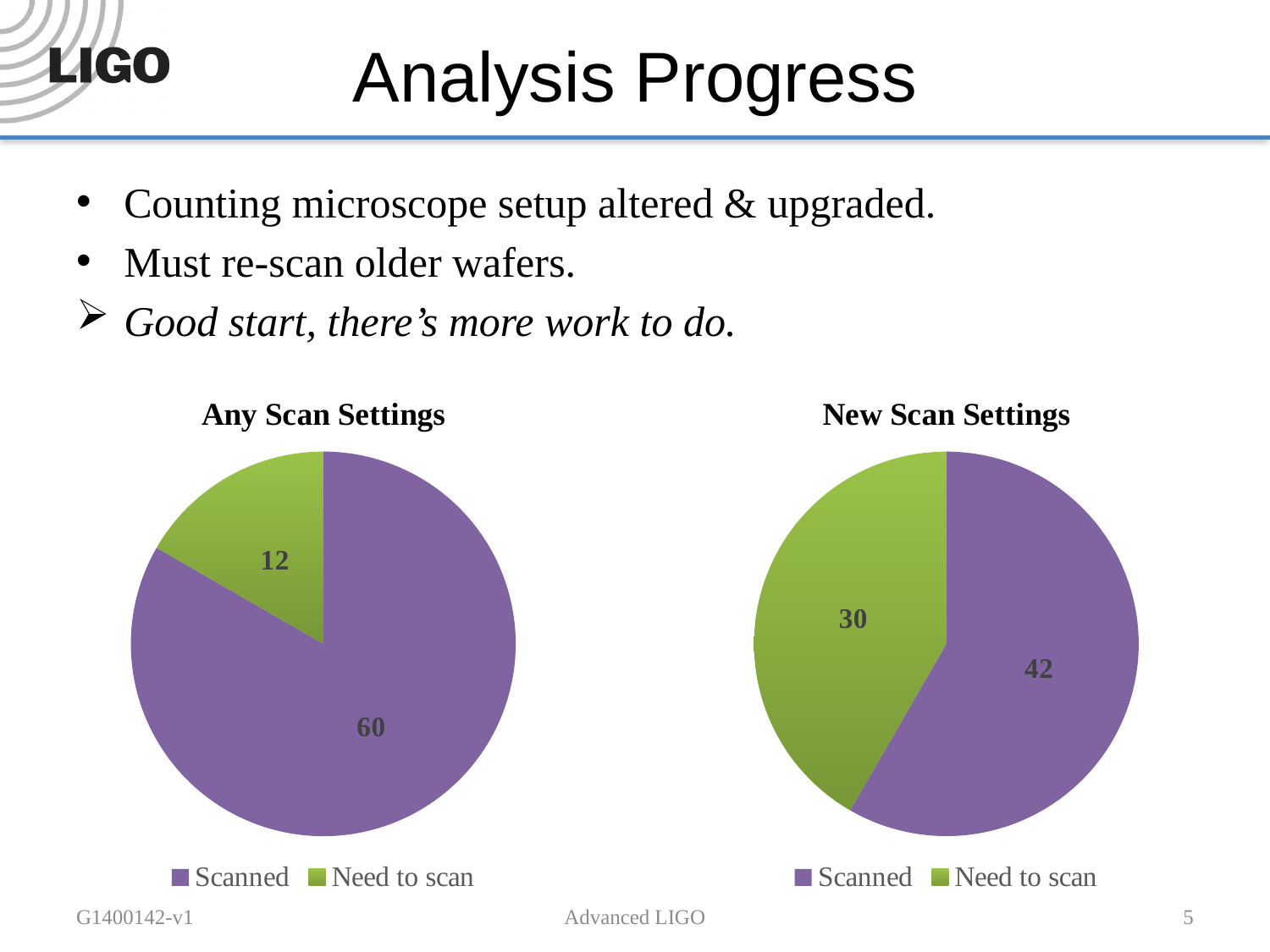
In the 'Any Scan Settings' chart, which category has the largest slice? Scanned In the 'New Scan Settings' chart, what is the difference between Scanned and Need to scan? 12 In the 'New Scan Settings' chart, which category has the smallest slice? Need to scan In the 'Any Scan Settings' chart, what is the value for Scanned? 60 In the 'Any Scan Settings' chart, what is the value for Need to scan? 12 In the 'New Scan Settings' chart, which is larger, Scanned or Need to scan? Scanned What type of chart is the 'Any Scan Settings' chart? Pie chart How many categories does the legend of the 'New Scan Settings' chart list? 2 In the 'Any Scan Settings' chart, what is the difference between Scanned and Need to scan? 48 In the 'New Scan Settings' chart, what is the value for Scanned? 42 In the 'New Scan Settings' chart, what is the value for Need to scan? 30